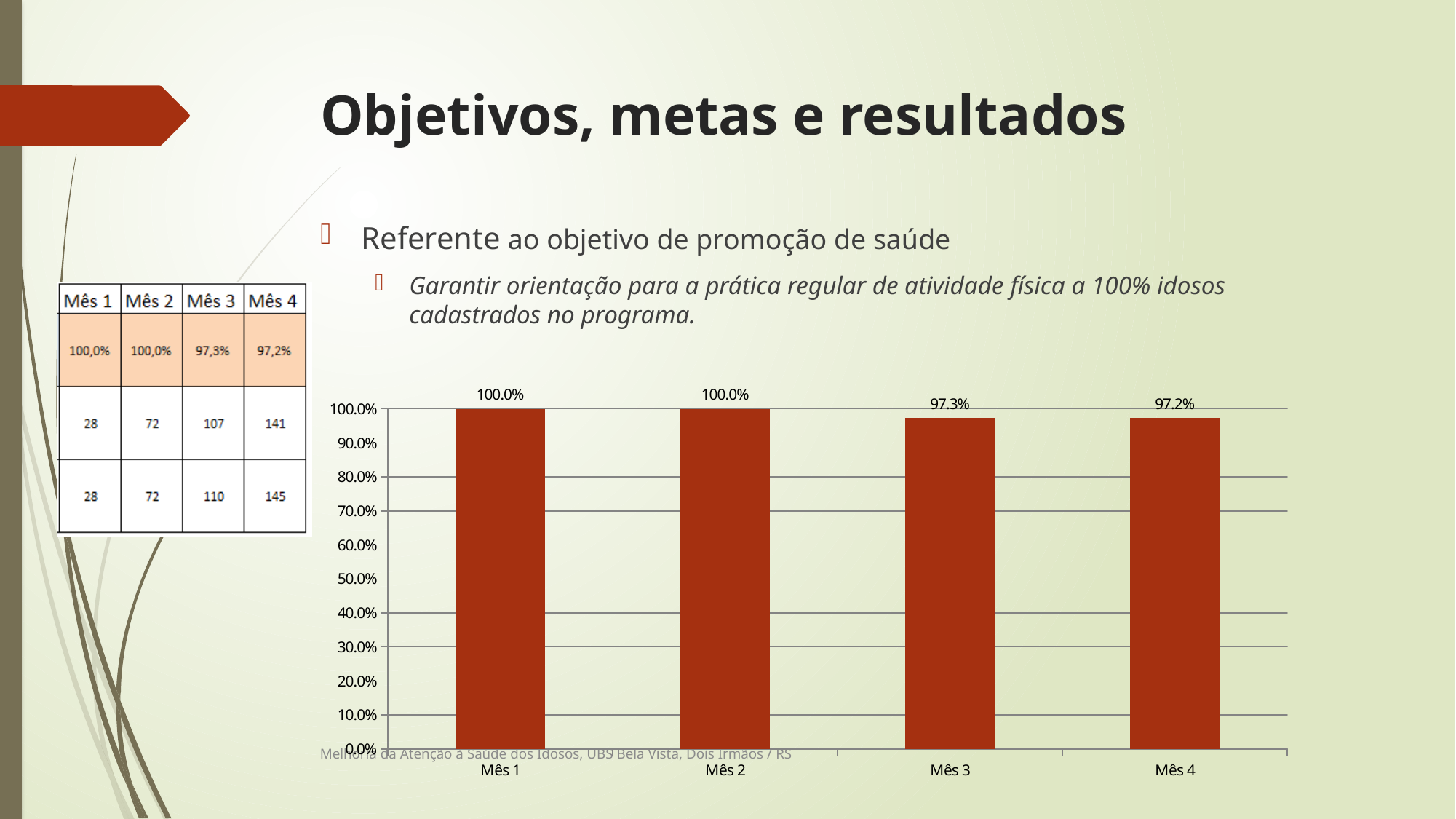
Which category has the lowest value in the bar chart? Mês 4 What is the difference between the values for Mês 1 and Mês 3 in the bar chart? 2.7% How many categories are shown on the x axis of the bar chart? 4 What is the value for Mês 2 in the bar chart? 100.0% What kind of chart is shown on the slide? bar chart What is the value for Mês 3 in the bar chart? 97.3% What is the value for Mês 1 in the bar chart? 100.0% Do the values in the bar chart rise or fall from Mês 2 to Mês 4? fall Is the value for Mês 3 greater or less than 90.0%? greater What is the difference between the values for Mês 2 and Mês 4 in the bar chart? 2.8% What is the value for Mês 4 in the bar chart? 97.2% Which is larger in the bar chart, the value for Mês 2 or the value for Mês 4? Mês 2